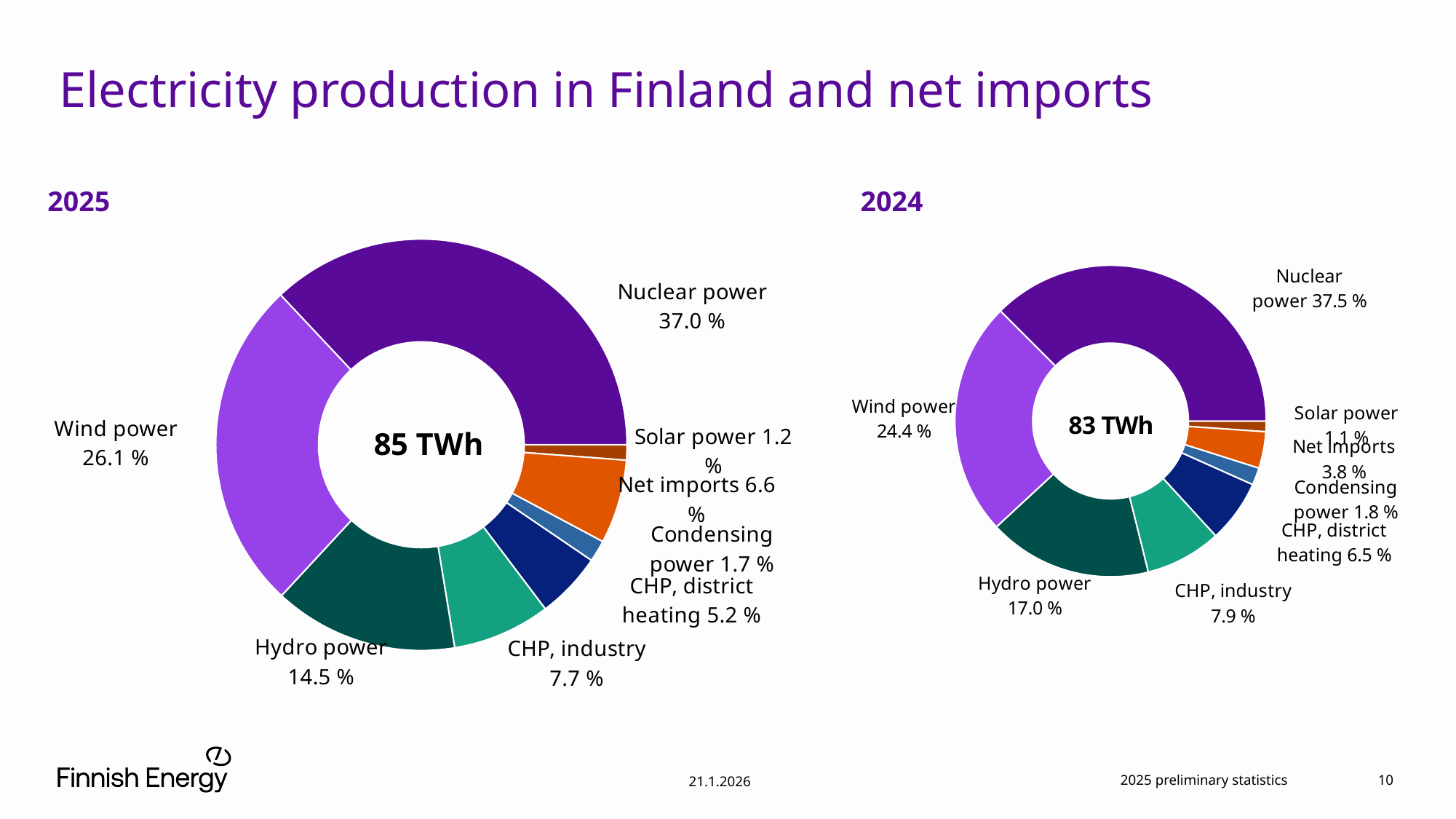
In the 2024 chart, what is the share of CHP, district heating? 6.5 % In the 2024 chart, which category has the smallest share? Solar power In the 2025 chart, what is the share of Net imports? 6.6 % How many slices does the 2025 chart have? 8 In the 2025 chart, what share does Wind power have? 26.1 % What kind of chart is used for the 2024 data? Pie (donut) chart In the 2024 chart, which is larger: the share of CHP, industry or the share of Net imports? CHP, industry What total is shown in the centre of the 2024 chart? 83 TWh In the 2025 chart, what is the difference between the Nuclear power share and the Wind power share? 10.9 % In the 2025 chart, which category has the largest share? Nuclear power In the 2024 chart, what share does Hydro power have? 17.0 % What total is shown in the centre of the 2025 chart? 85 TWh